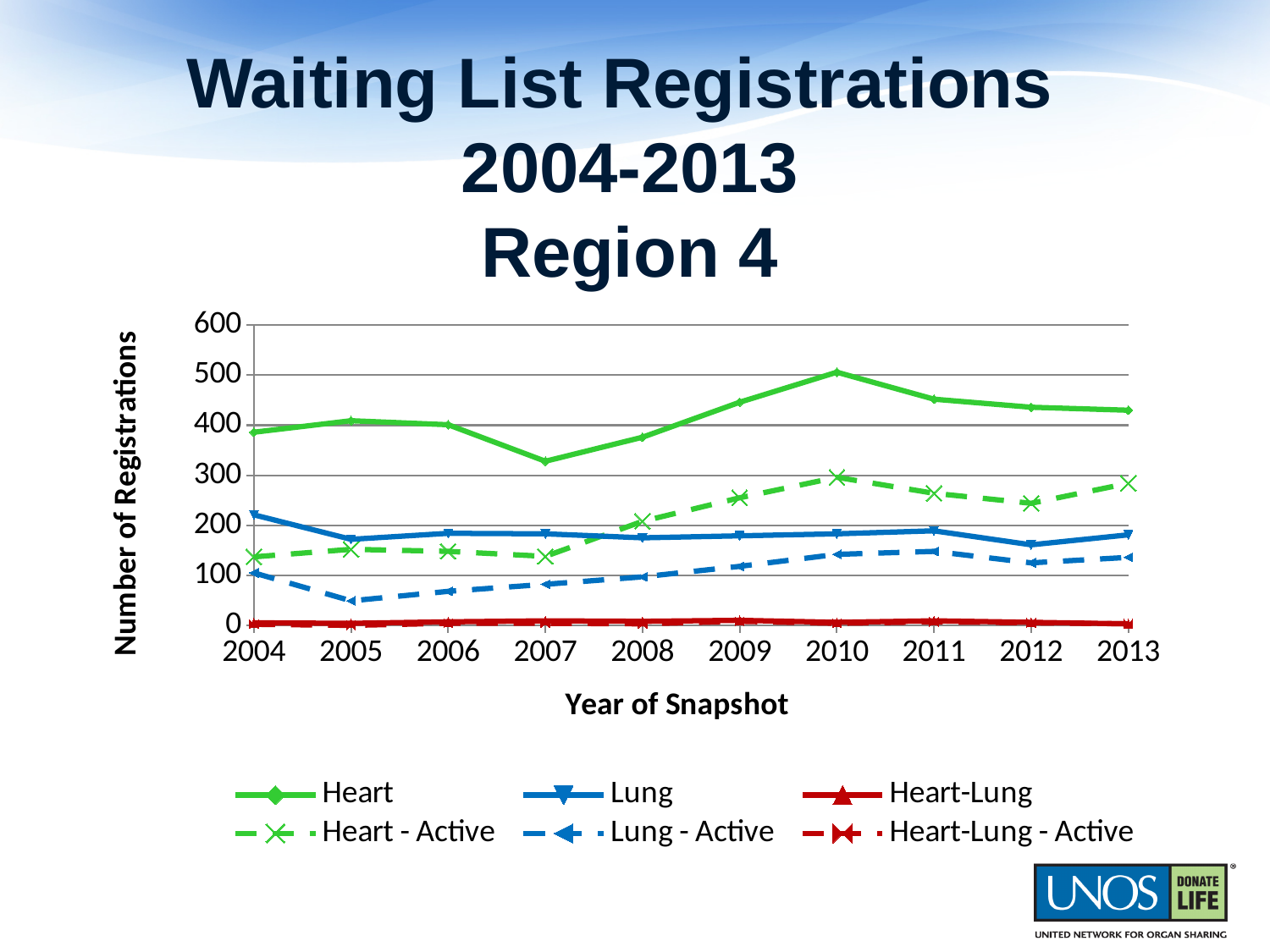
What kind of chart is shown on the slide? line chart How many series does the legend list? 6 In which year does the Heart series reach its highest value? 2010 Is the value for Lung in 2004 greater or less than 200? greater Is the value for Lung - Active in 2005 greater or less than 100? less In which year is the Lung - Active series at its lowest? 2005 Is the value for Heart in 2010 greater or less than 400? greater How many years are plotted along the x axis? 10 In which year does the Heart series reach its lowest value? 2007 Which is larger, the Lung value in 2004 or the Lung value in 2012? 2004 Does the Heart series rise or fall from 2010 to 2013? fall